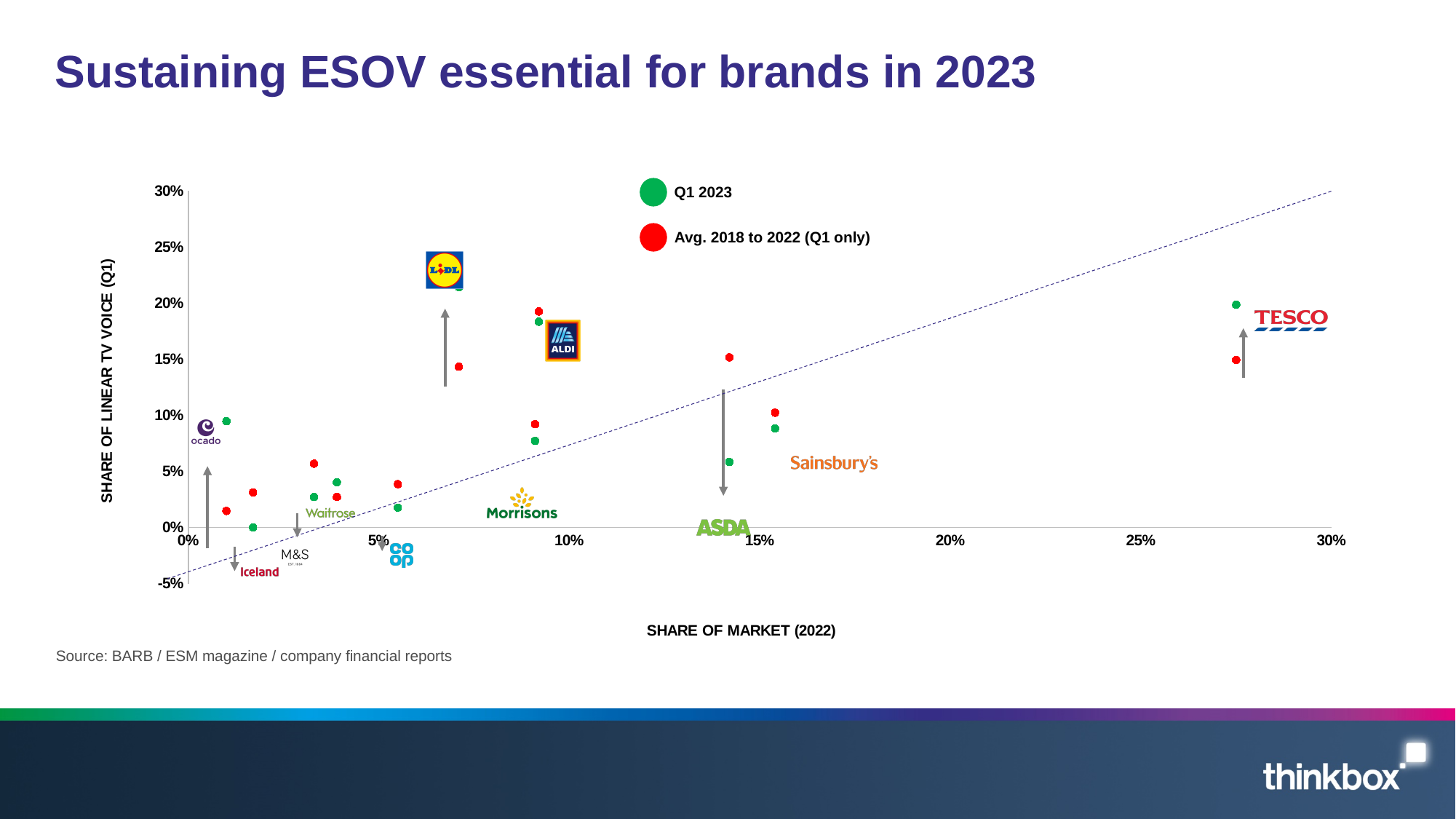
For Tesco, which is larger: the Q1 2023 share of voice or the Avg. 2018 to 2022 share of voice? Q1 2023 Is the Q1 2023 share of linear TV voice for Lidl greater or less than 20%? greater Which brand has the highest share of market (2022)? Tesco Is the Q1 2023 share of linear TV voice for ASDA greater or less than 10%? less How many series does the legend list? 2 Is the Q1 2023 share of linear TV voice for Tesco greater or less than 15%? greater What kind of chart is shown on the slide? Scatter chart What are the two series named in the legend? Q1 2023 and Avg. 2018 to 2022 (Q1 only) What is the title of the horizontal axis? SHARE OF MARKET (2022) For ASDA, which is larger: the Q1 2023 share of voice or the Avg. 2018 to 2022 share of voice? Avg. 2018 to 2022 (Q1 only)